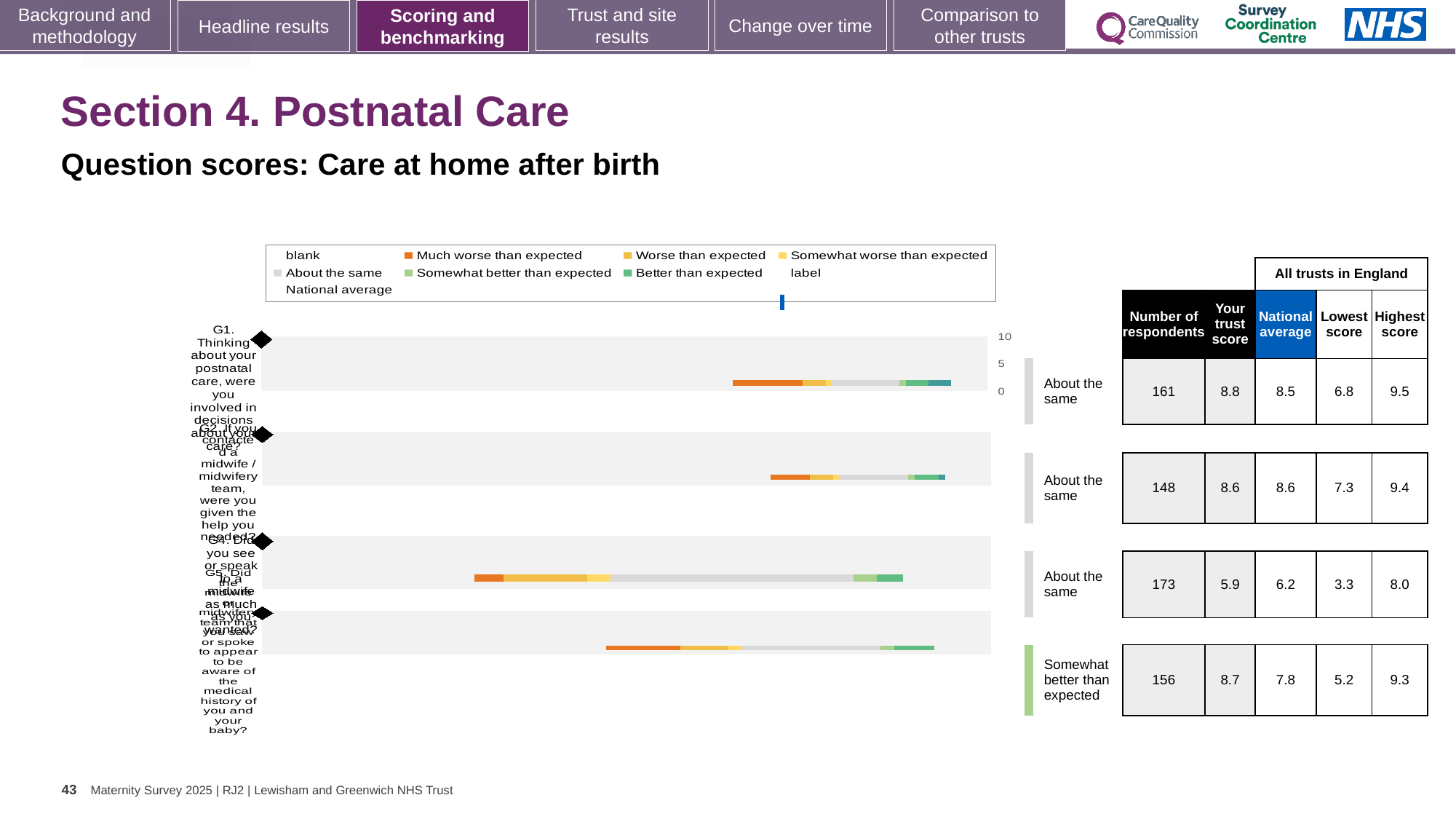
What is the highest score across all trusts in England for G2 in the table beside the chart? 9.4 Which question has the highest trust score in the table beside the chart? G1 What kind of chart is used to show the question scores for care at home after birth? bar chart What is the difference between the trust score and the national average for G5 in the table beside the chart? 0.9 According to the table beside the chart, what is the national average for G4 (see or speak to a midwife as much as you wanted)? 6.2 Which question has the lowest trust score in the table beside the chart? G4 Is the trust score for G2 larger or smaller than the trust score for G4 in the table beside the chart? larger What colour does the legend use for 'Much worse than expected'? orange According to the table beside the chart, how many respondents answered G5 (midwife aware of the medical history of you and your baby)? 156 According to the table beside the chart, what is the trust score for G1 (involved in decisions about your postnatal care)? 8.8 How many questions (bars) are plotted in the chart? 4 Which question is rated 'Somewhat better than expected' next to the chart? G5